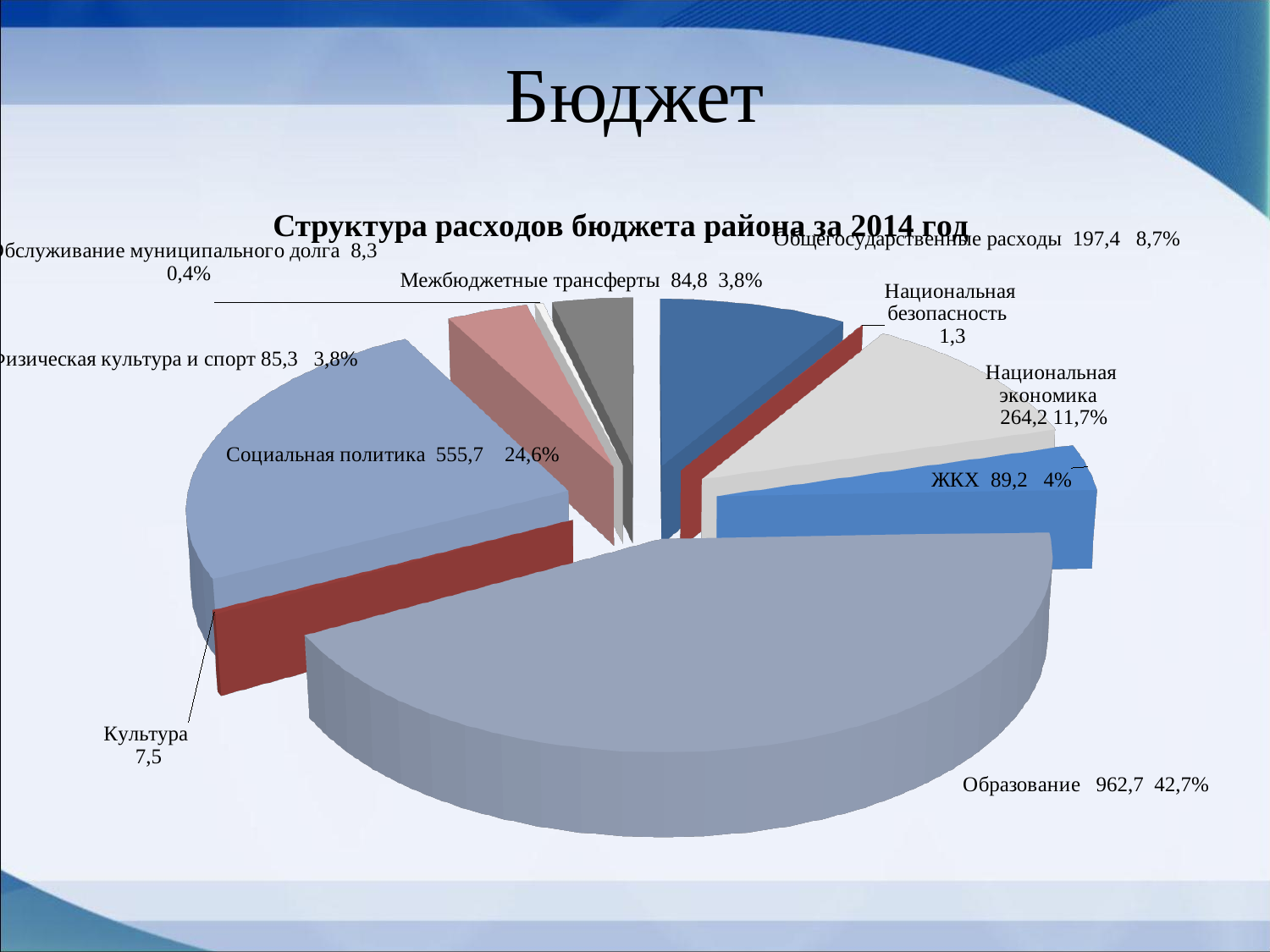
What type of chart is shown on the slide? pie chart What share of the pie does Общегосударственные расходы represent? 8,7% Which is larger, the value for Национальная экономика or the value for Общегосударственные расходы? Национальная экономика What is the value shown for Социальная политика? 555,7 What is the difference between the values for Образование and Социальная политика? 407 Which category has the largest slice of the pie? Образование What is the value shown for Образование? 962,7 What is the value shown for ЖКХ? 89,2 What is the title of the chart? Структура расходов бюджета района за 2014 год What share of the pie does Национальная экономика represent? 11,7% Which category has the smallest value in the pie? Национальная безопасность How many categories (slices) are shown in the pie chart? 10